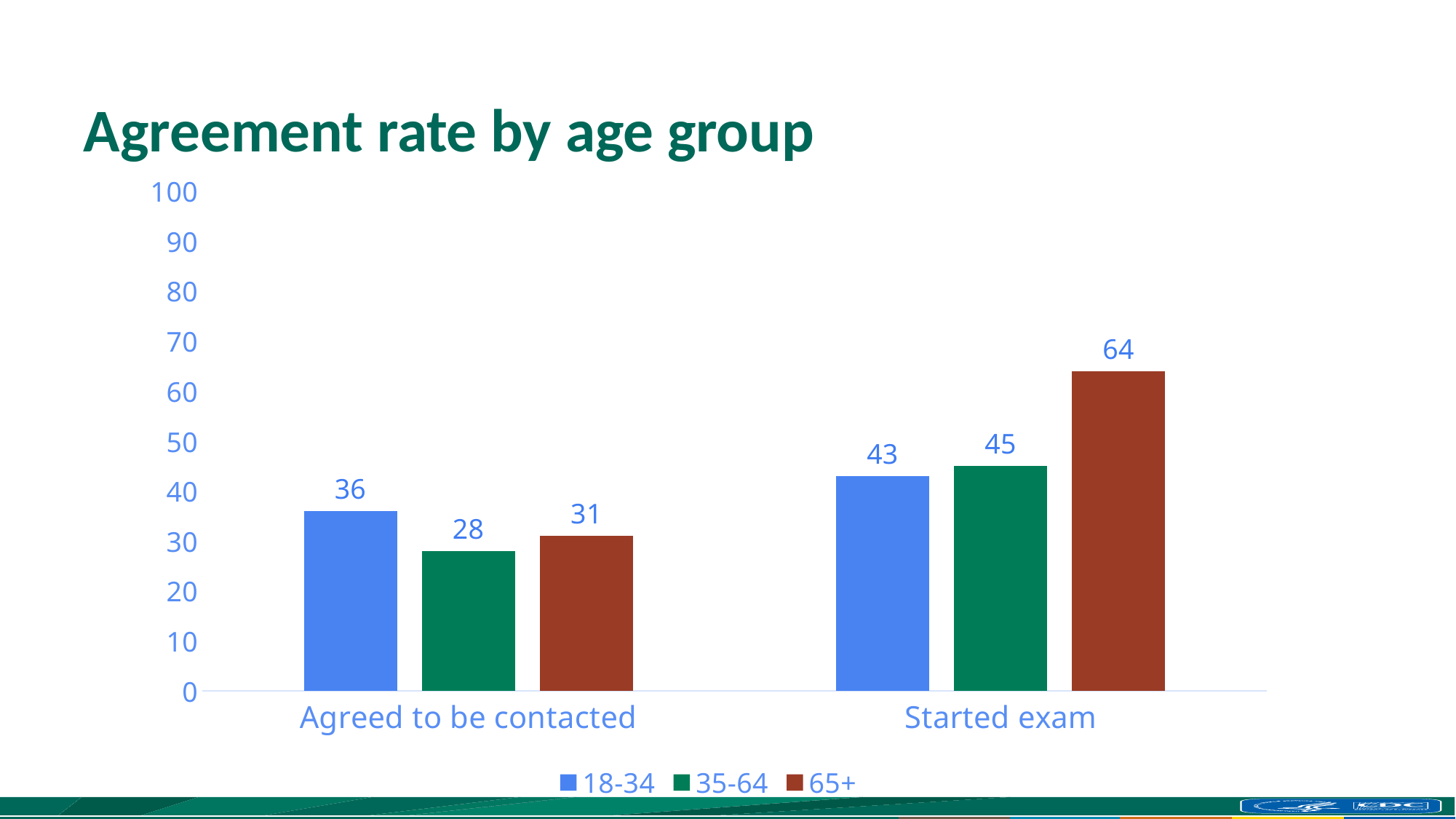
How many series does the legend list? 3 How many categories are shown on the x axis? 2 What is the difference between the 65+ and 18-34 values in the 'Started exam' category? 21 What is the title of the chart? Agreement rate by age group What is the value for the 18-34 age group in the 'Agreed to be contacted' category? 36 What is the difference between the 18-34 and 35-64 values in the 'Agreed to be contacted' category? 8 What kind of chart is shown on the slide? Bar chart Which age group has the lowest value in the 'Agreed to be contacted' category? 35-64 Which is larger: the 18-34 value for 'Agreed to be contacted' or the 65+ value for 'Agreed to be contacted'? 18-34 Which age group has the highest value in the 'Started exam' category? 65+ What is the value for the 65+ age group in the 'Started exam' category? 64 What is the value for the 35-64 age group in the 'Agreed to be contacted' category? 28